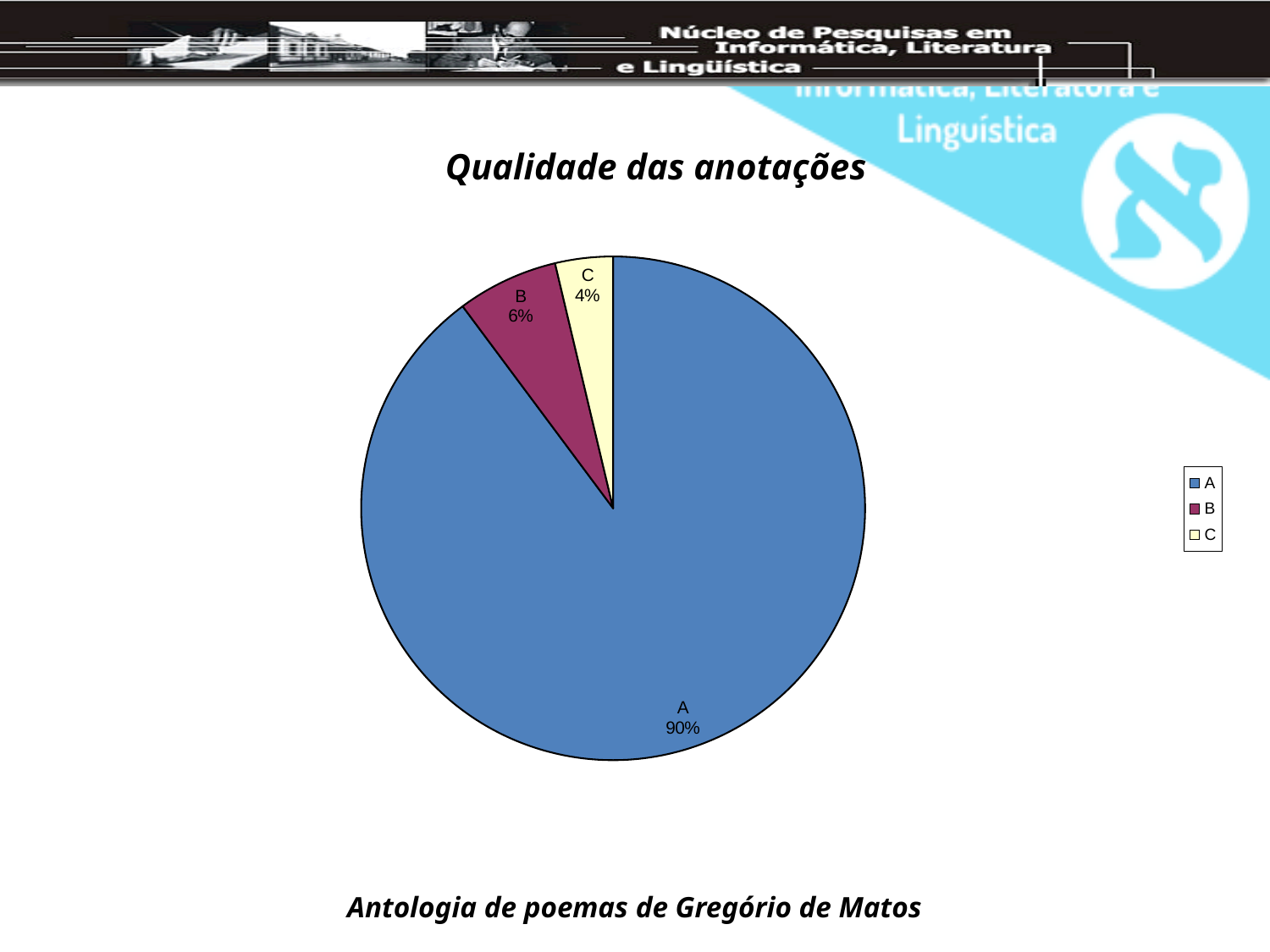
How many entries does the legend list? 3 What is the difference in percentage points between the shares of A and B? 84 What is the difference in percentage points between the shares of B and C? 2 Which category has the smallest slice of the pie? C What share of the pie does category B represent? 6% What share of the pie does category C represent? 4% How many categories are shown in the pie chart? 3 Which category has the largest slice of the pie? A What share of the pie does category A represent? 90% Which is larger, the share of B or the share of C? B What is the title of the chart? Qualidade das anotações What kind of chart is shown on the slide? pie chart